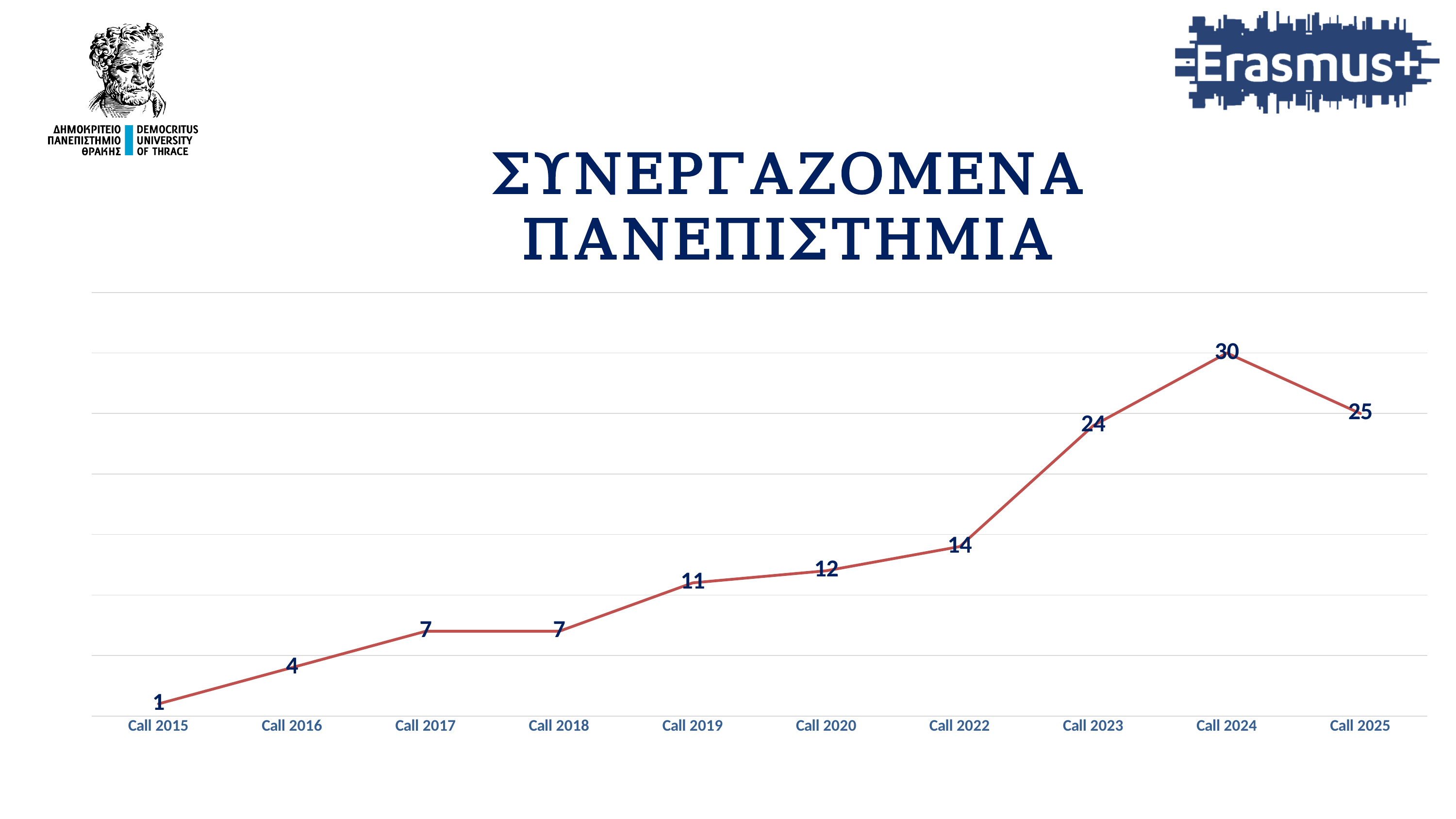
Which is larger, the value for Call 2019 or the value for Call 2020? Call 2020 Which call has the highest value? Call 2024 Which call has the lowest value? Call 2015 What kind of chart is shown on the slide? Line chart What is the difference between the values for Call 2023 and Call 2022? 10 What is the difference between the values for Call 2024 and Call 2025? 5 What is the value for Call 2024? 30 What is the value for Call 2025? 25 How many calls are plotted on the x axis? 10 What is the value for Call 2022? 14 What is the value for Call 2015? 1 Do the values rise or fall from Call 2015 to Call 2024? Rise